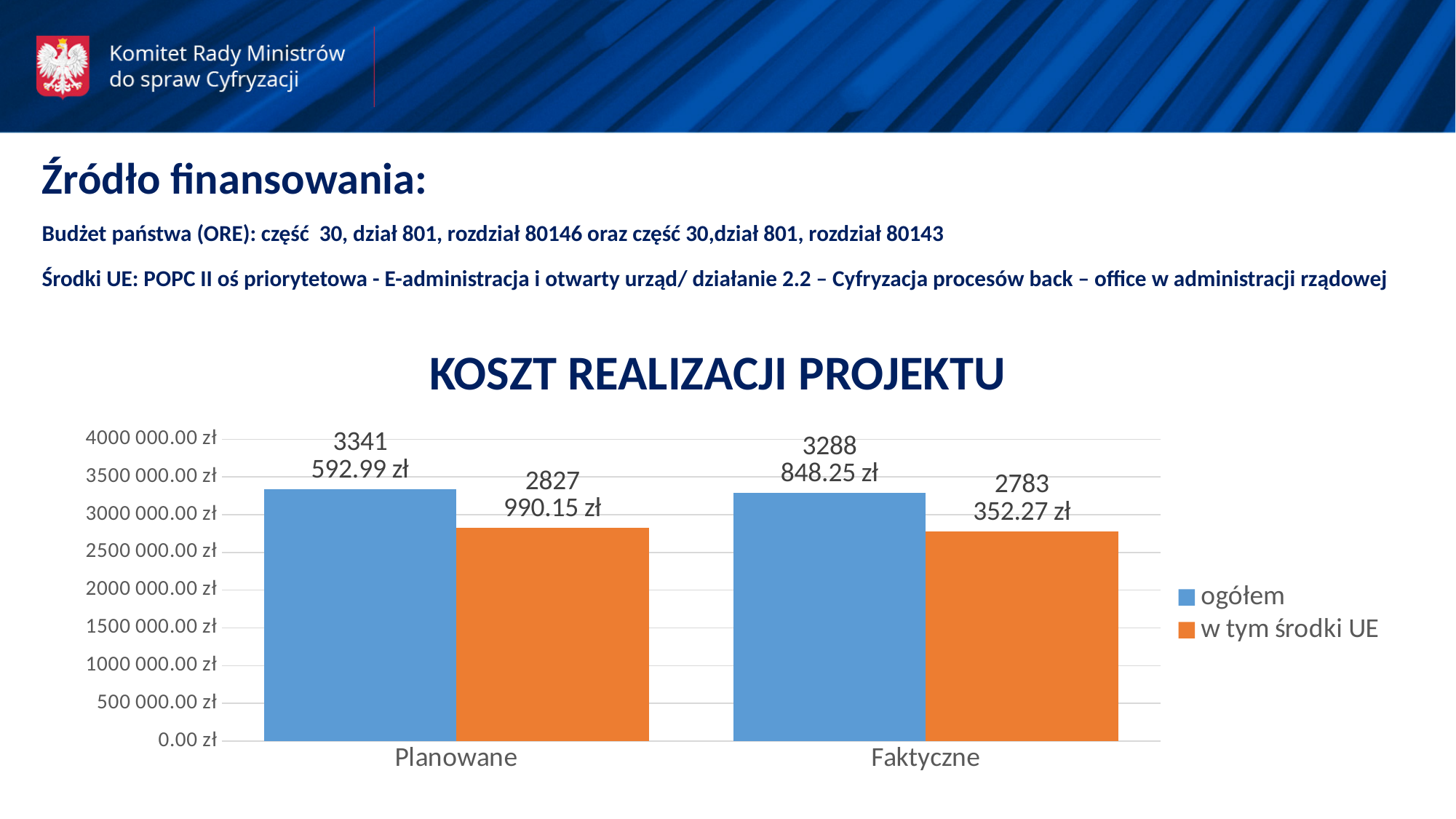
What type of chart is shown on the slide? bar chart How many categories are shown on the x axis? 2 What is the value of 'w tym środki UE' for Planowane? 2827 990.15 zł How many series does the legend list? 2 What is the value of 'ogółem' for Faktyczne? 3288 848.25 zł What is the difference between 'ogółem' for Planowane and 'ogółem' for Faktyczne? 52 744.74 zł What is the value of 'w tym środki UE' for Faktyczne? 2783 352.27 zł Which is larger: 'w tym środki UE' for Planowane or 'w tym środki UE' for Faktyczne? Planowane What is the value of 'ogółem' for Planowane? 3341 592.99 zł What is the difference between 'ogółem' and 'w tym środki UE' for Planowane? 513 602.84 zł Which bar has the highest value in the chart? ogółem for Planowane Which bar has the lowest value in the chart? w tym środki UE for Faktyczne